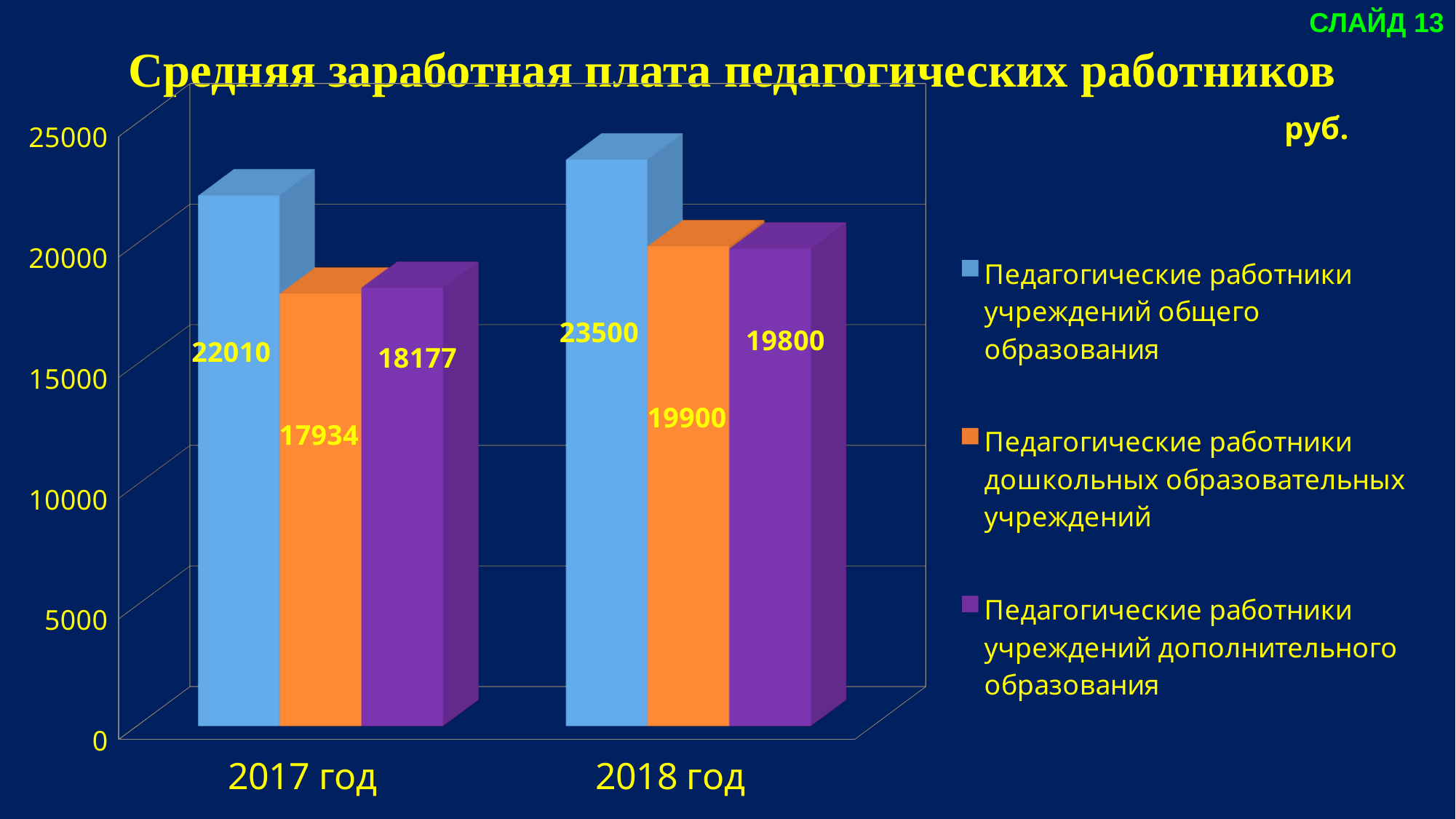
Сколько рядов данных перечислено в легенде диаграммы? 3 У какой категории педагогических работников самая низкая средняя заработная плата в 2017 году? Педагогические работники дошкольных образовательных учреждений Какого типа эта диаграмма? Столбчатая (bar chart) Как изменяется средняя заработная плата педагогических работников учреждений дополнительного образования от 2017 к 2018 году — растёт или падает? Растёт Какова средняя заработная плата педагогических работников учреждений общего образования в 2018 году? 23500 Что больше в 2018 году: средняя заработная плата педагогических работников дошкольных образовательных учреждений или учреждений дополнительного образования? Педагогические работники дошкольных образовательных учреждений Какова средняя заработная плата педагогических работников дошкольных образовательных учреждений в 2018 году? 19900 Какова средняя заработная плата педагогических работников учреждений дополнительного образования в 2017 году? 18177 На сколько средняя заработная плата педагогических работников дошкольных образовательных учреждений в 2018 году больше, чем в 2017 году? 1966 На сколько выросла средняя заработная плата педагогических работников учреждений общего образования с 2017 по 2018 год? 1490 У какой категории педагогических работников самая высокая средняя заработная плата в 2018 году? Педагогические работники учреждений общего образования Какова средняя заработная плата педагогических работников учреждений общего образования в 2017 году? 22010